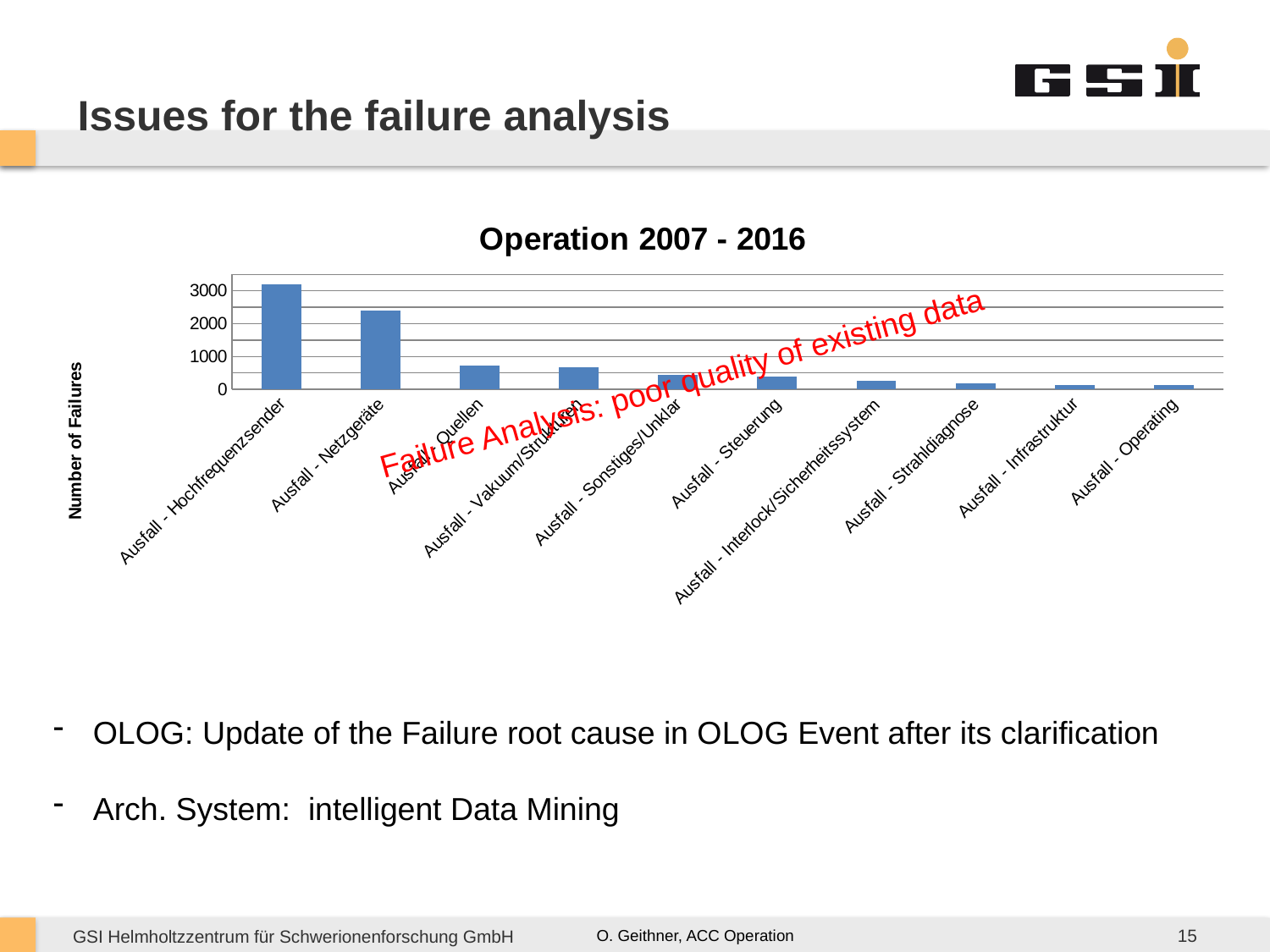
Is the value for Ausfall - Interlock/Sicherheitssystem greater or less than 1000? less Do the bar values generally rise or fall from left to right along the x axis? fall What is the title of the chart? Operation 2007 - 2016 What kind of chart is shown on the slide? bar chart What is the label of the vertical axis of the chart? Number of Failures Is the value for Ausfall - Hochfrequenzsender greater or less than 3000? greater Which is larger, the value for Ausfall - Netzgeräte or the value for Ausfall - Strahldiagnose? Ausfall - Netzgeräte Is the value for Ausfall - Netzgeräte greater or less than 2000? greater Which category has the highest number of failures? Ausfall - Hochfrequenzsender Which is larger, the value for Ausfall - Hochfrequenzsender or the value for Ausfall - Netzgeräte? Ausfall - Hochfrequenzsender How many categories are plotted in the chart? 10